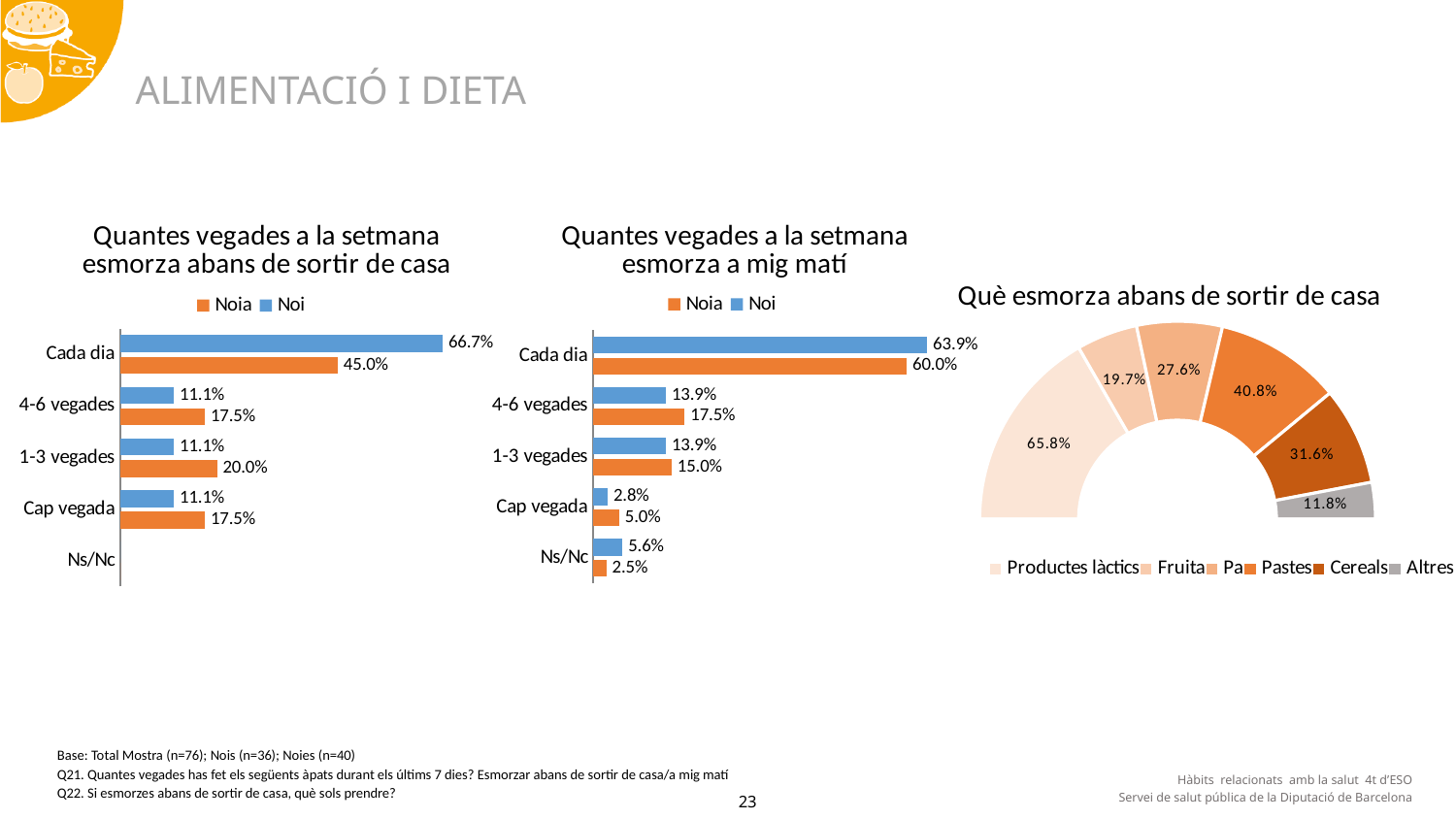
In the chart 'Quantes vegades a la setmana esmorza a mig matí', what is the value for Noia in the 'Cada dia' category? 60.0% In the chart 'Quantes vegades a la setmana esmorza abans de sortir de casa', what is the value for Noia in the '1-3 vegades' category? 20.0% In the chart 'Quantes vegades a la setmana esmorza abans de sortir de casa', what is the difference between the Noi and Noia values for 'Cada dia'? 21.7% In the chart 'Quantes vegades a la setmana esmorza a mig matí', which is larger for 'Ns/Nc': the Noi value or the Noia value? Noi In the chart 'Quantes vegades a la setmana esmorza abans de sortir de casa', what is the value for Noi in the 'Cada dia' category? 66.7% In the chart 'Què esmorza abans de sortir de casa', which category has the lowest value? Altres In the chart 'Quantes vegades a la setmana esmorza a mig matí', what is the value for Noi in the 'Cap vegada' category? 2.8% What kind of chart is 'Quantes vegades a la setmana esmorza a mig matí'? Bar chart In the chart 'Què esmorza abans de sortir de casa', what is the value for Productes làctics? 65.8% In the chart 'Què esmorza abans de sortir de casa', what is the value for Pastes? 40.8% In the chart 'Quantes vegades a la setmana esmorza a mig matí', how many categories are shown on the axis? 5 In the chart 'Quantes vegades a la setmana esmorza abans de sortir de casa', how many series does the legend list? 2